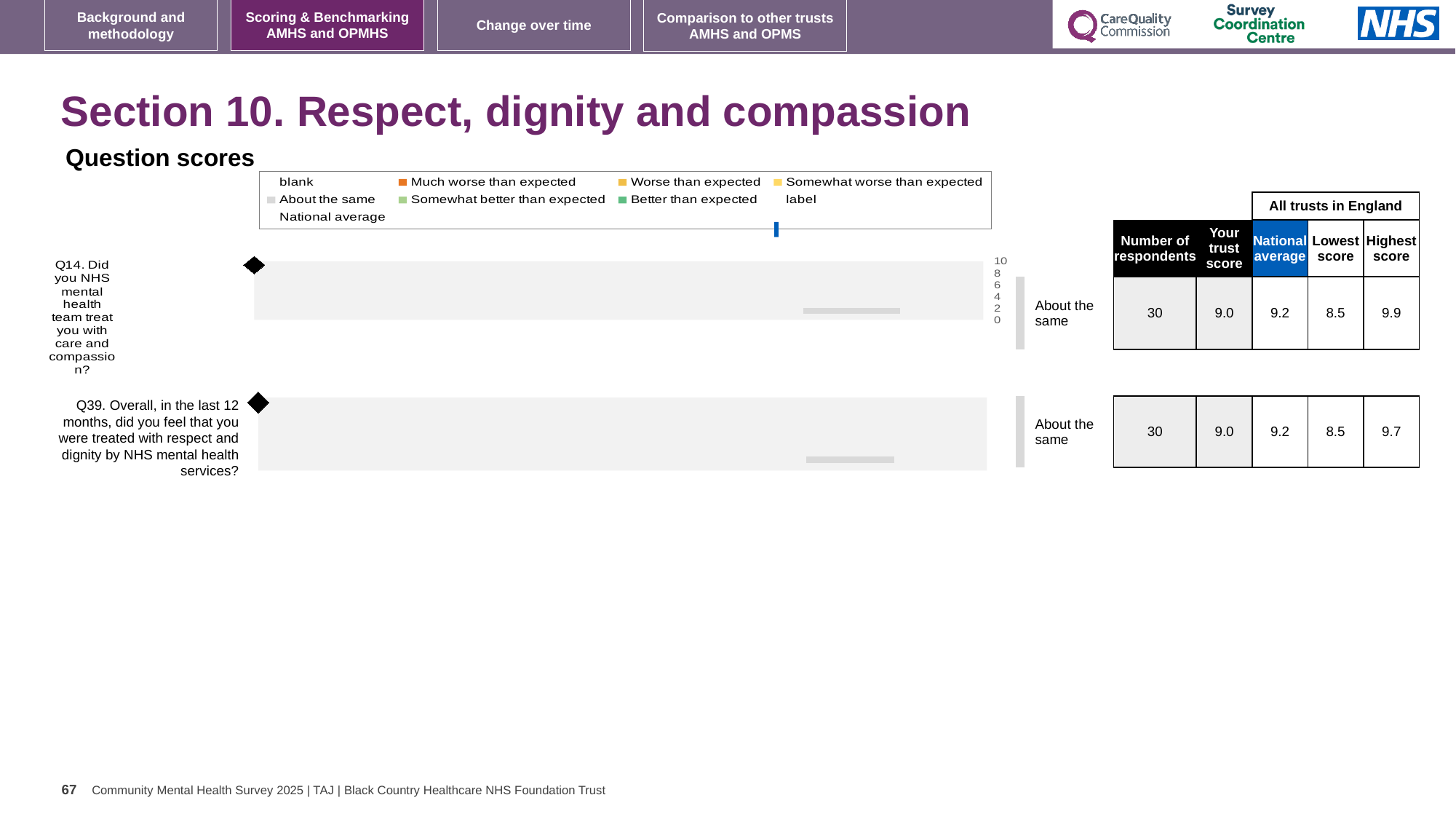
What kind of chart is used to show the question scores on this slide? bar chart How many respondents answered Q39? 30 What is the highest score among all trusts in England for Q14? 9.9 What is the difference between the highest score for Q14 (9.9) and the highest score for Q39 (9.7)? 0.2 What is the lowest score among all trusts in England for Q39? 8.5 Which legend entry is shown with an orange marker? Much worse than expected Which question has the higher 'Highest score' across all trusts in England, Q14 or Q39? Q14 What is the national average score for Q39 (treated with respect and dignity)? 9.2 How many questions (categories) are plotted in the question scores chart? 2 What benchmark category is shown next to the bar for Q39? About the same For Q14, which is larger: the trust's score or the national average? National average What is the 'Your trust score' for Q14 (treated with care and compassion)? 9.0